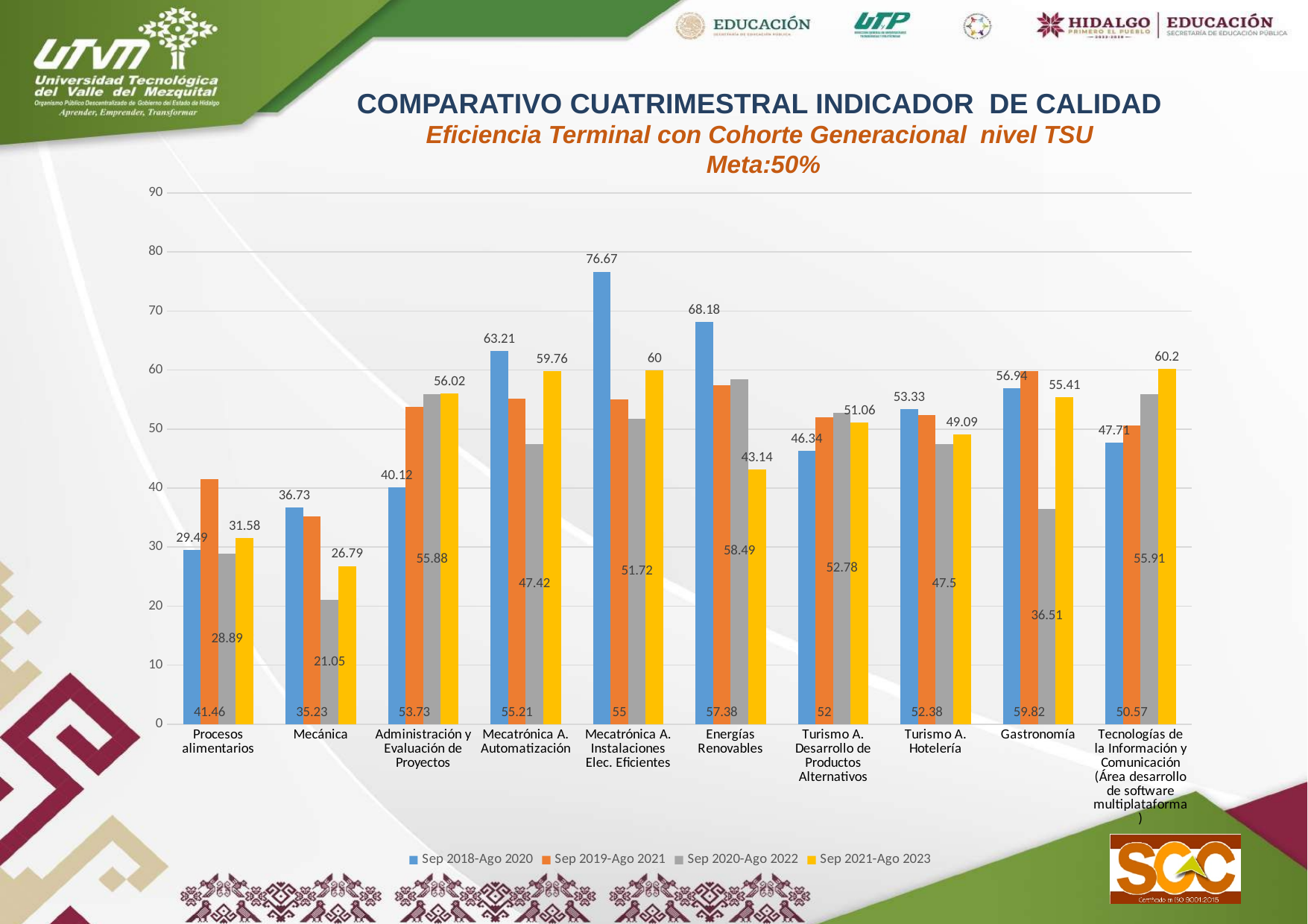
How many series does the legend list? 4 What is the Sep 2021-Ago 2023 value for Tecnologías de la Información y Comunicación? 60.2 What is the Sep 2020-Ago 2022 value for Energías Renovables? 58.49 For Gastronomía, what is the difference between the Sep 2019-Ago 2021 value and the Sep 2020-Ago 2022 value? 23.31 What is the Sep 2018-Ago 2020 value for Mecatrónica A. Instalaciones Elec. Eficientes? 76.67 What is the Sep 2019-Ago 2021 value for Procesos alimentarios? 41.46 What target (Meta) is stated in the chart title? 50% For Energías Renovables, which is larger: the Sep 2018-Ago 2020 value or the Sep 2021-Ago 2023 value? Sep 2018-Ago 2020 What kind of chart is shown on the slide? bar chart Which category has the lowest Sep 2020-Ago 2022 value? Mecánica How many program categories are shown along the x axis? 10 Which category has the highest Sep 2018-Ago 2020 value? Mecatrónica A. Instalaciones Elec. Eficientes